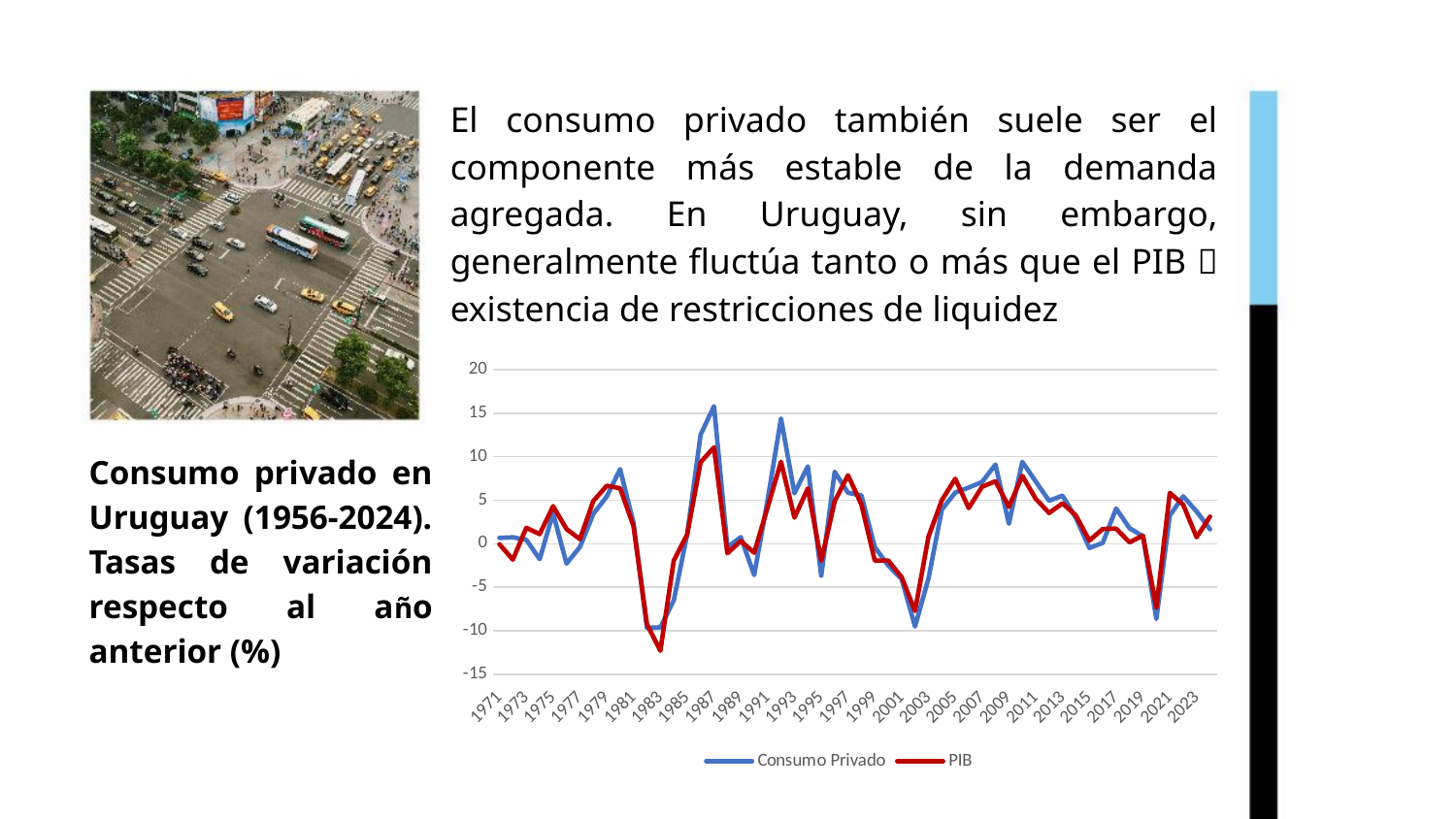
Is the value of Consumo Privado in 2002 greater or less than -5? less In which year does the PIB line reach its highest value? 1987 Which colour is used for the PIB line in the chart? red In which year does the PIB line reach its lowest value? 1983 Which series has the higher value in 1992, Consumo Privado or PIB? Consumo Privado Is the value of Consumo Privado in 1986 greater or less than 10? greater What are the two series named in the chart legend? Consumo Privado and PIB What kind of chart is shown on the slide? line chart How many series does the chart legend list? 2 Is the value of PIB in 1992 greater or less than 5? greater